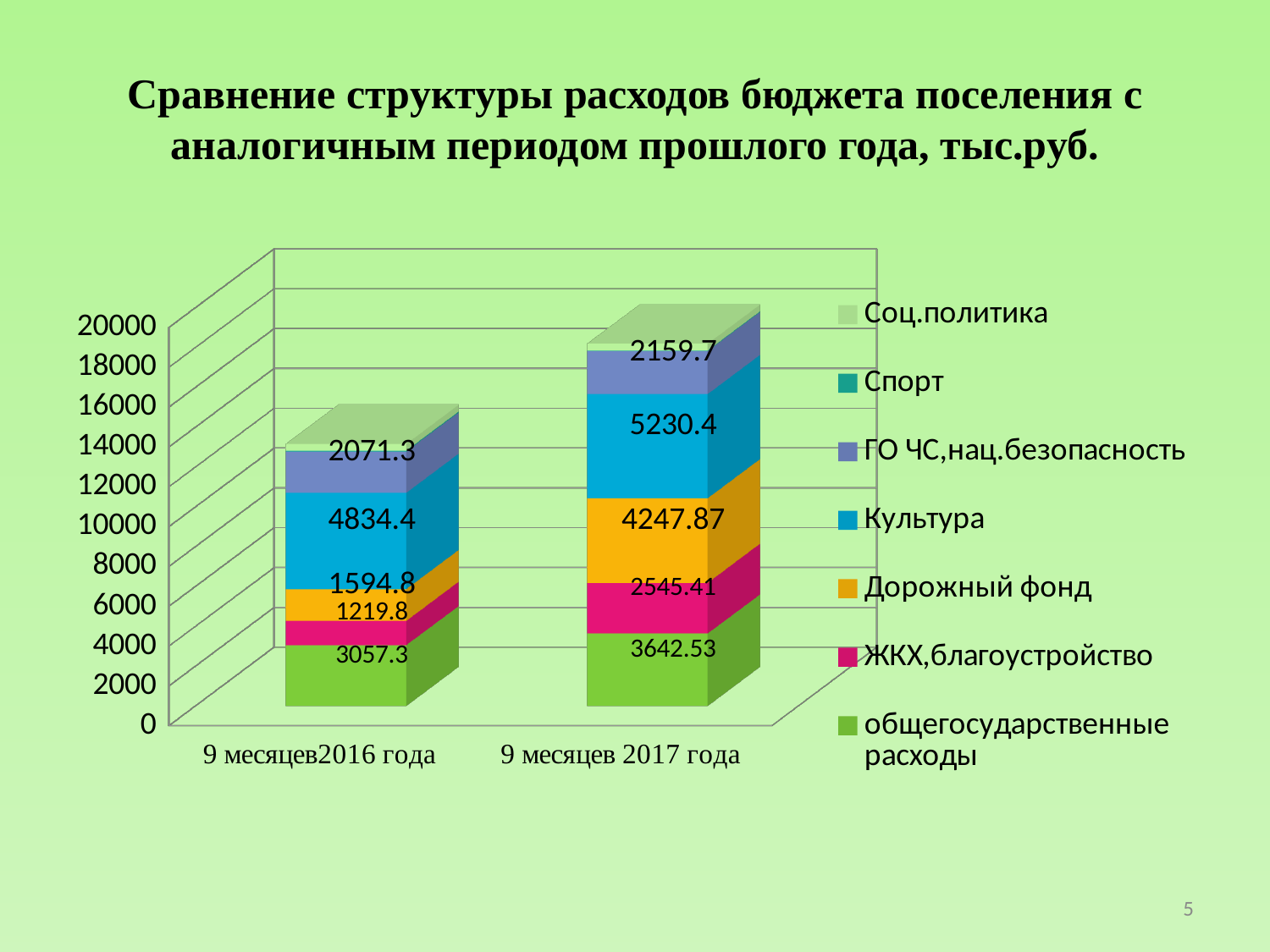
What is the value for ГО ЧС,нац.безопасность in the 9 месяцев 2017 года bar? 2159.7 What is the value for Дорожный фонд in the 9 месяцев 2017 года bar? 4247.87 By how much did Культура increase from 9 месяцев2016 года to 9 месяцев 2017 года? 396 What is the difference between ГО ЧС,нац.безопасность in 9 месяцев 2017 года and in 9 месяцев2016 года? 88.4 What is the difference between ЖКХ,благоустройство in 9 месяцев 2017 года and in 9 месяцев2016 года? 1325.61 What kind of chart is shown on the slide? Stacked bar chart Which labelled series has the largest value in the 9 месяцев 2017 года bar? Культура How many series does the legend list? 7 Which period has the larger value for Дорожный фонд, 9 месяцев2016 года or 9 месяцев 2017 года? 9 месяцев 2017 года What is the value for Культура in the 9 месяцев 2017 года bar? 5230.4 What is the value for ЖКХ,благоустройство in the 9 месяцев2016 года bar? 1219.8 What is the value for общегосударственные расходы in the 9 месяцев2016 года bar? 3057.3